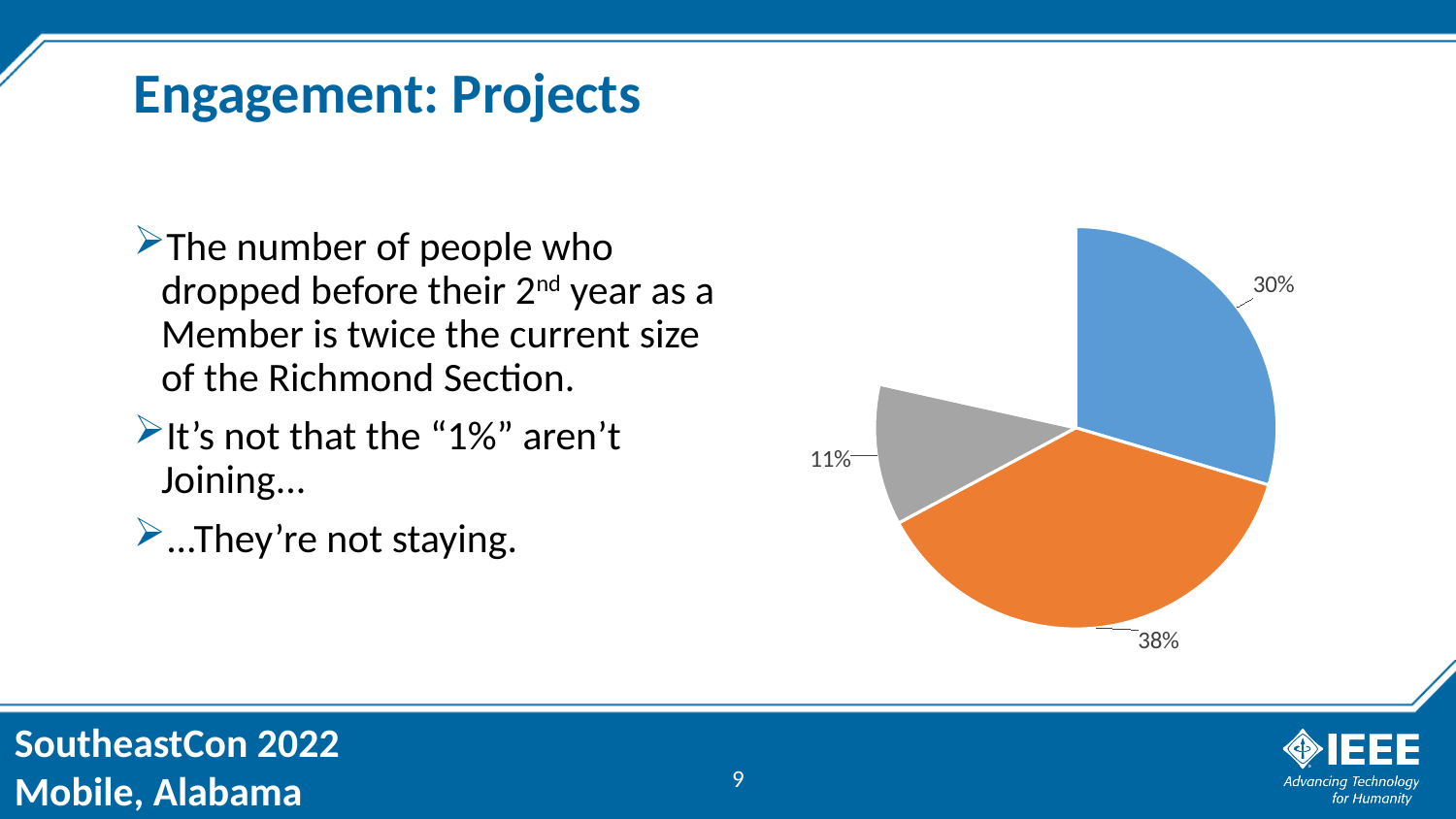
What is the difference between the blue slice's percentage and the gray slice's percentage? 19 percentage points What is the difference between the orange slice's percentage and the blue slice's percentage? 8 percentage points What percentage is shown for the orange slice of the pie chart? 38% Does the pie chart include a legend? No Which is larger, the blue slice or the gray slice? the blue slice What kind of chart is shown on the slide? pie chart Which slice of the pie chart is the largest? the orange slice (38%) What percentage is shown for the blue slice of the pie chart? 30% Is the value of the orange slice greater or less than 35%? greater What percentage is shown for the gray slice of the pie chart? 11%